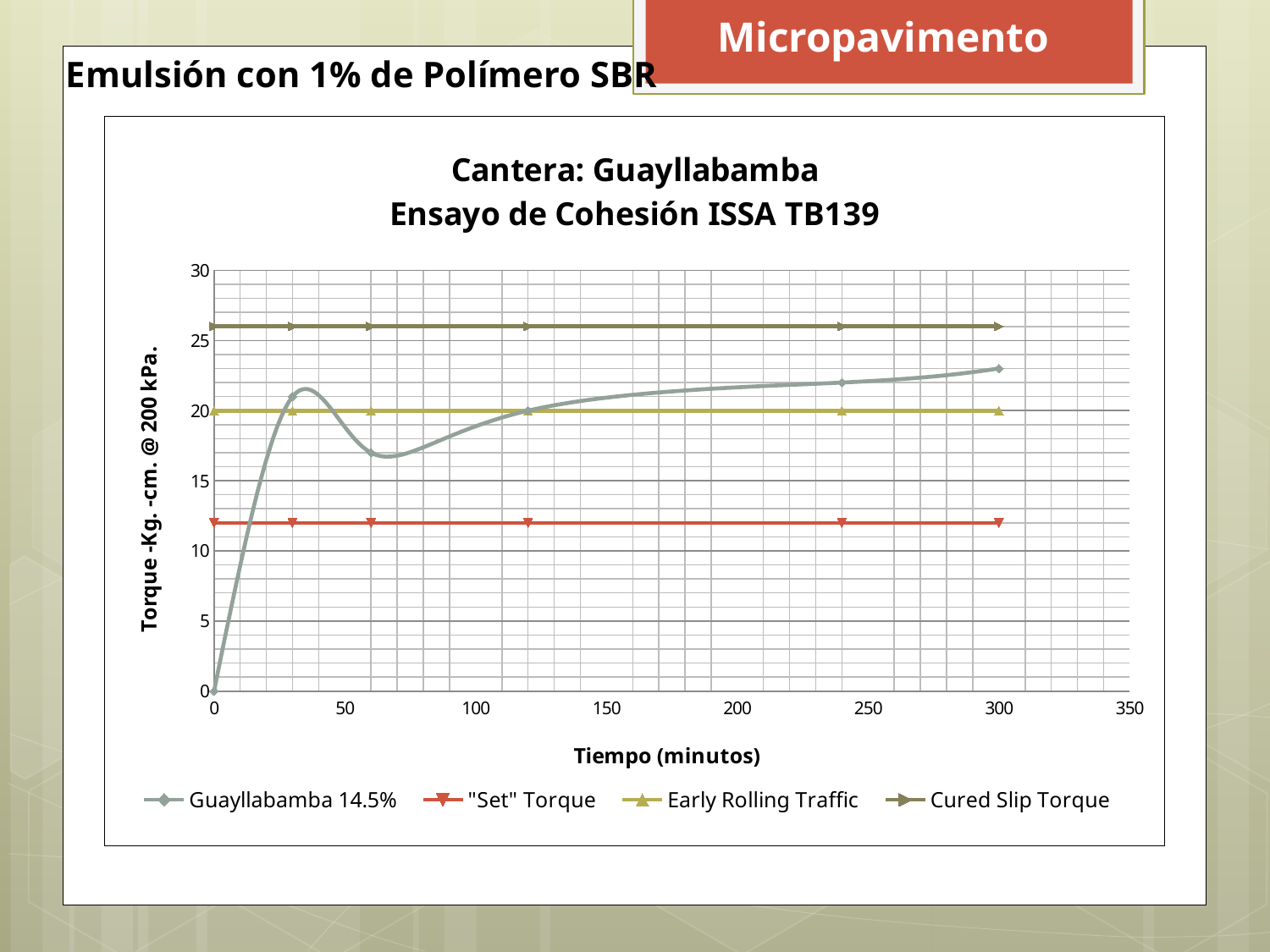
What kind of chart is shown on the slide? line chart How many series does the legend list? 4 What is the value of the Guayllabamba 14.5% series at 0 minutes? 0 What is the value of the Early Rolling Traffic line? 20 Is the value of the "Set" Torque line greater or less than 15? less Which is larger at 240 minutes: the Guayllabamba 14.5% series or the "Set" Torque line? Guayllabamba 14.5% Is the value of the Cured Slip Torque line greater or less than 25? greater Is the value of the Guayllabamba 14.5% series at 300 minutes greater or less than 20? greater What is the label of the x axis? Tiempo (minutos) What is the title of the chart? Cantera: Guayllabamba Ensayo de Cohesión ISSA TB139 Which series has the highest values across the chart? Cured Slip Torque